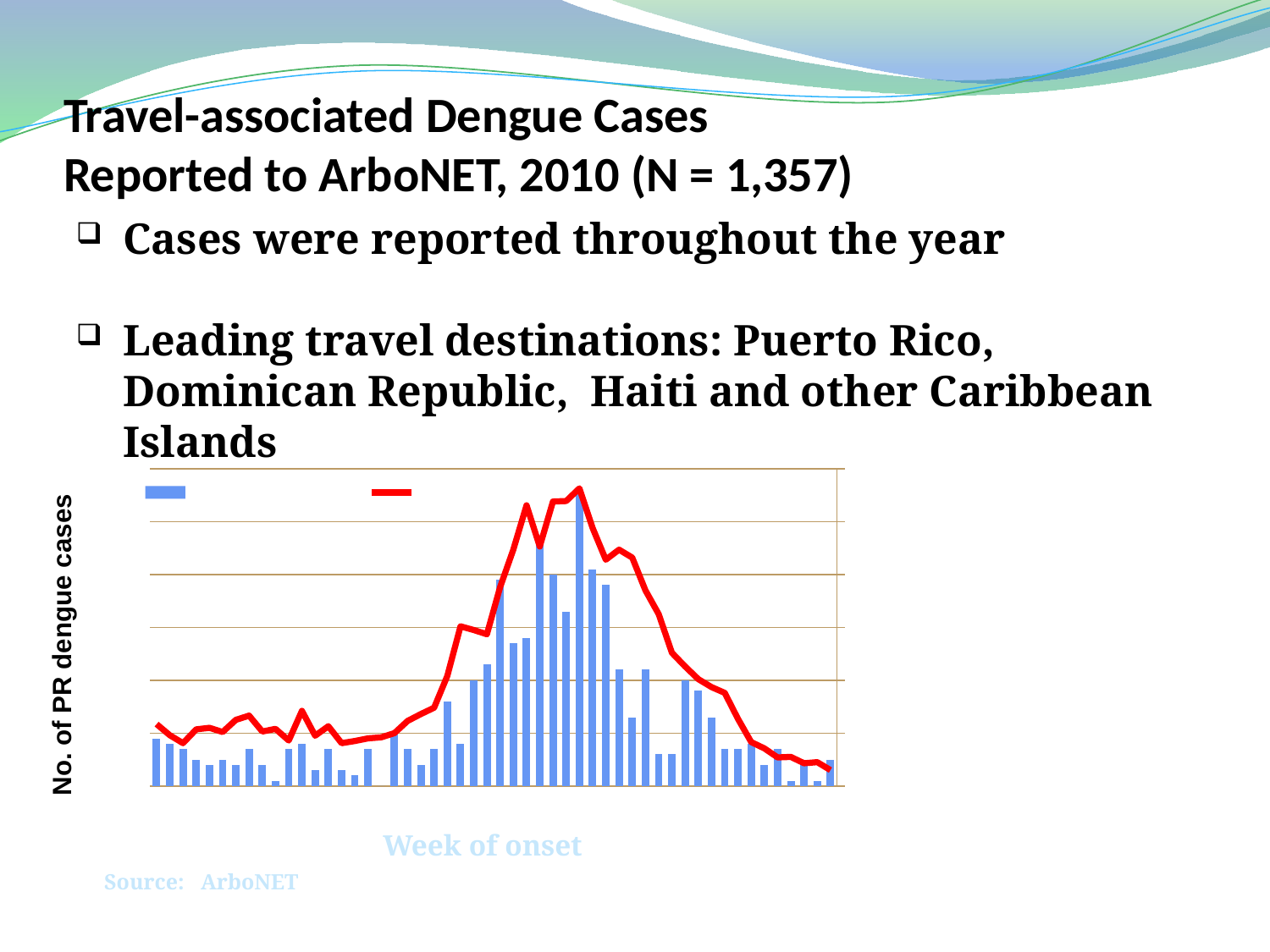
What kind of chart is shown on the slide? A bar chart with a line series overlaid How many series does the chart's legend list? 2 Do the red line values rise or fall from the middle of the chart toward the end of the x axis? Fall What is the title of the chart's vertical axis? No. of PR dengue cases Is the tallest bar located near the beginning, the middle, or the end of the x axis? The middle What is the title of the chart's horizontal axis? Week of onset Do the bar values rise or fall from the start of the x axis toward the middle of the chart? Rise